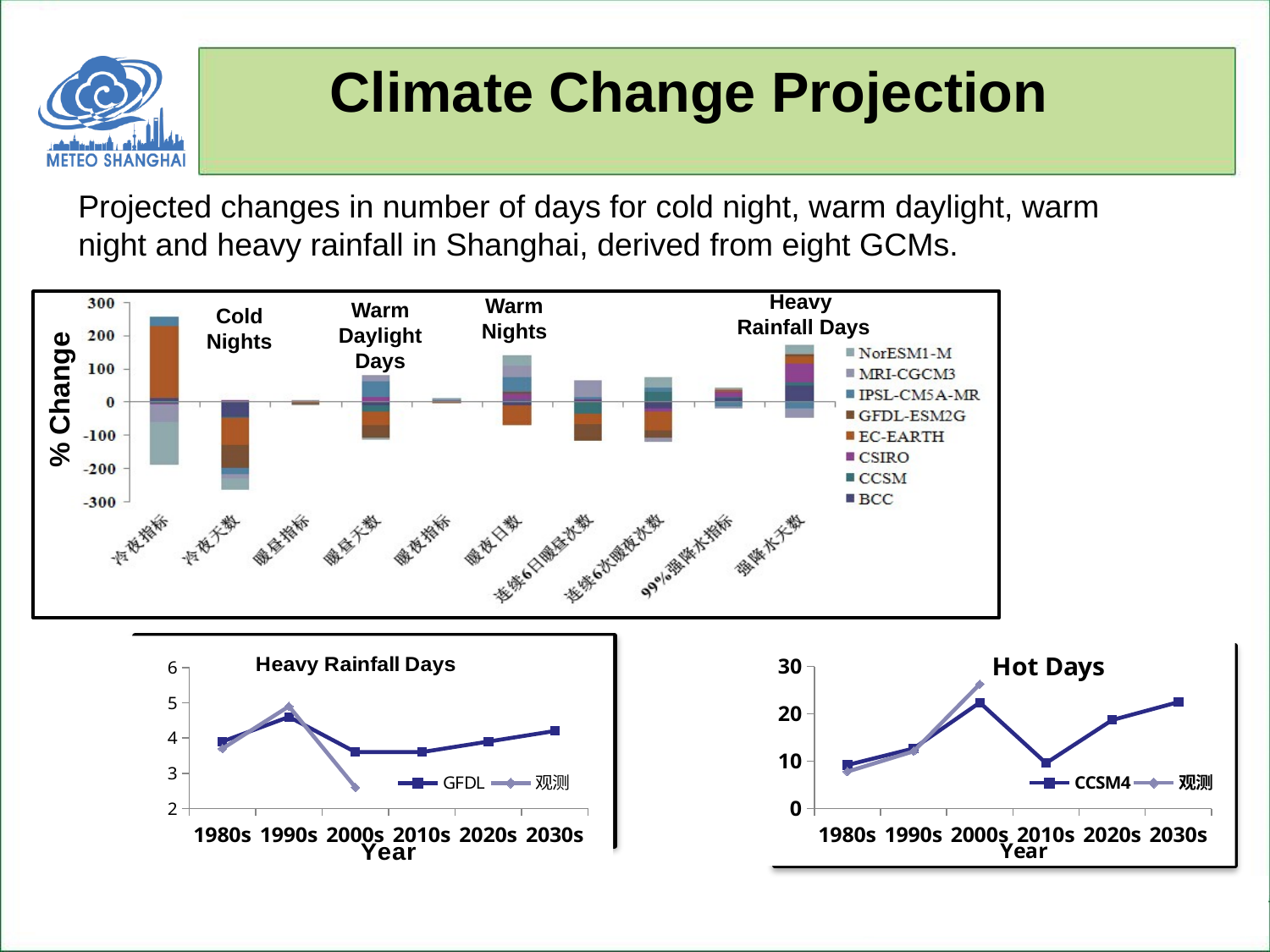
In the Hot Days chart, is the CCSM4 value for the 2000s greater or less than 20? greater How many series does the legend of the Heavy Rainfall Days chart list? 2 What kind of chart is the top chart showing % Change? stacked bar chart How many bars (categories) are plotted in the top % Change chart? 10 In the Heavy Rainfall Days chart, is the 观测 value for the 2000s greater or less than 3? less What kind of chart is the Heavy Rainfall Days chart? line chart How many points along the Year axis does the Heavy Rainfall Days chart have? 6 In the Heavy Rainfall Days chart, is the GFDL value for the 2030s greater or less than 4? greater In the top % Change chart, which series is listed first in the legend? NorESM1-M How many series does the legend of the top % Change chart list? 8 In the Heavy Rainfall Days chart, in which decade does the GFDL series reach its highest value? 1990s In the Hot Days chart, which is larger for CCSM4: the 2000s value or the 2010s value? 2000s